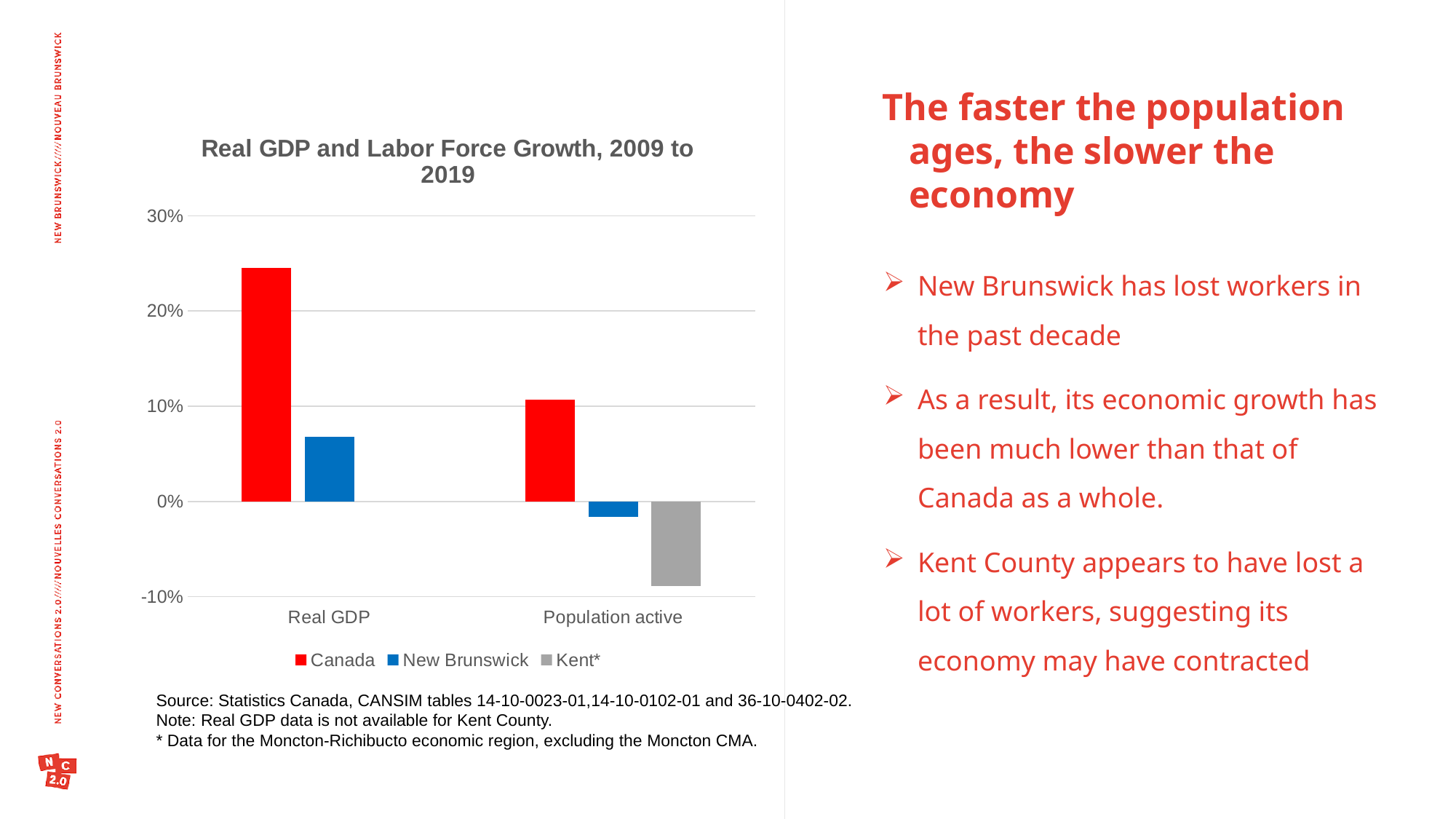
Is the value for New Brunswick in Real GDP greater or less than 10%? less Which series has the lowest value for Population active? Kent* For Real GDP, which is larger: Canada or New Brunswick? Canada Is the value for Canada in Real GDP greater or less than 20%? greater How many categories are shown on the x axis? 2 Is the value for Kent* in Population active greater or less than 0%? less Which series is shown in grey? Kent* What kind of chart is shown on the slide? bar chart What is the title of the chart? Real GDP and Labor Force Growth, 2009 to 2019 Which series has the highest value for Real GDP? Canada How many series does the legend list? 3 For Population active, which is larger: New Brunswick or Kent*? New Brunswick